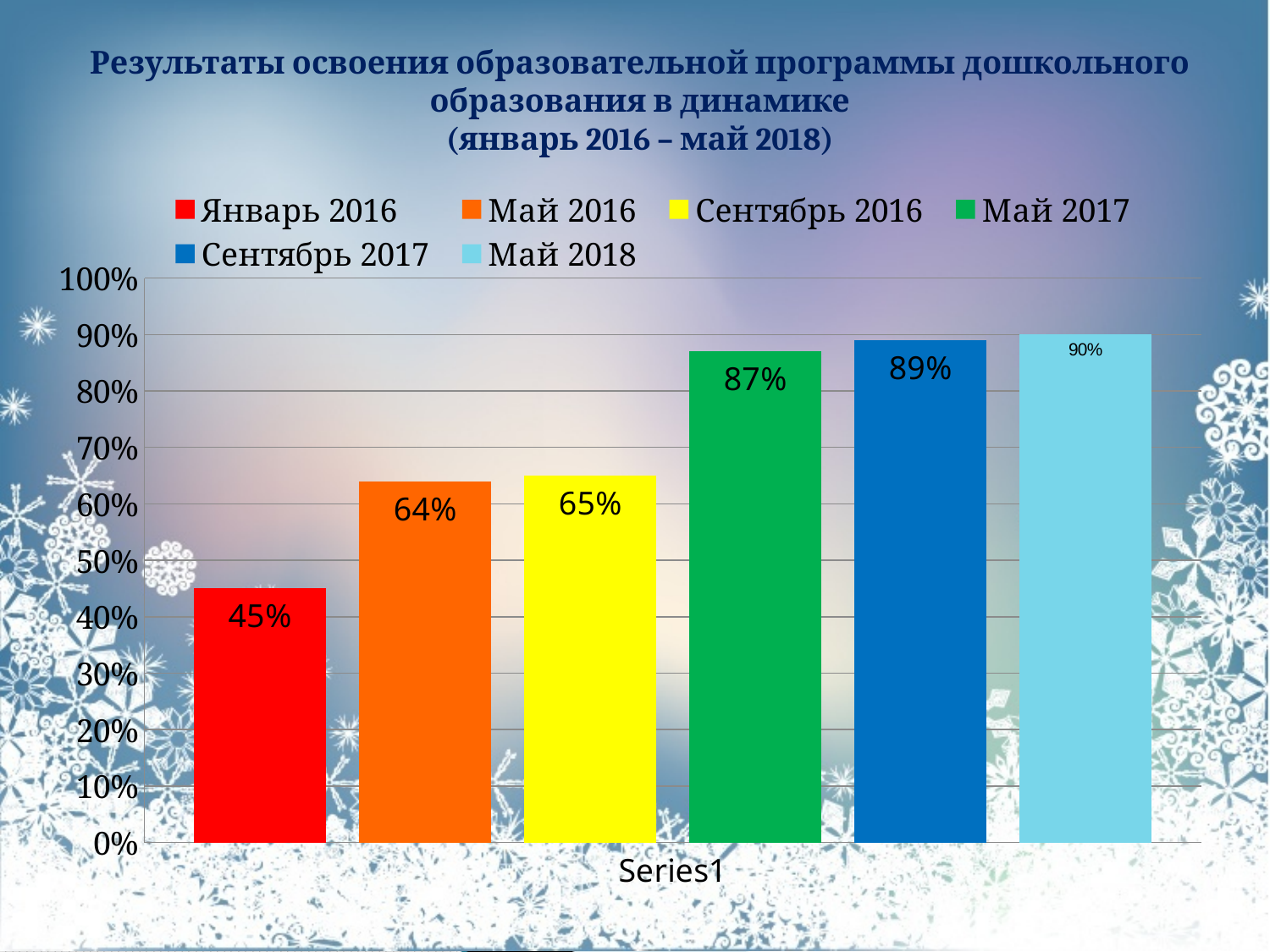
What is the value for Май 2018? 90% How many series does the legend list? 6 What is the value for Январь 2016? 45% What is the difference between the values for Май 2016 and Январь 2016? 19% Do the values rise or fall from Январь 2016 to Май 2018? rise What is the value for Май 2017? 87% Which series has the lowest value? Январь 2016 Which is larger, the value for Сентябрь 2017 or the value for Май 2016? Сентябрь 2017 Which series has the highest value? Май 2018 What colour is the bar for Сентябрь 2016? yellow What is the difference between the values for Май 2017 and Сентябрь 2016? 22% What kind of chart is shown on the slide? bar chart